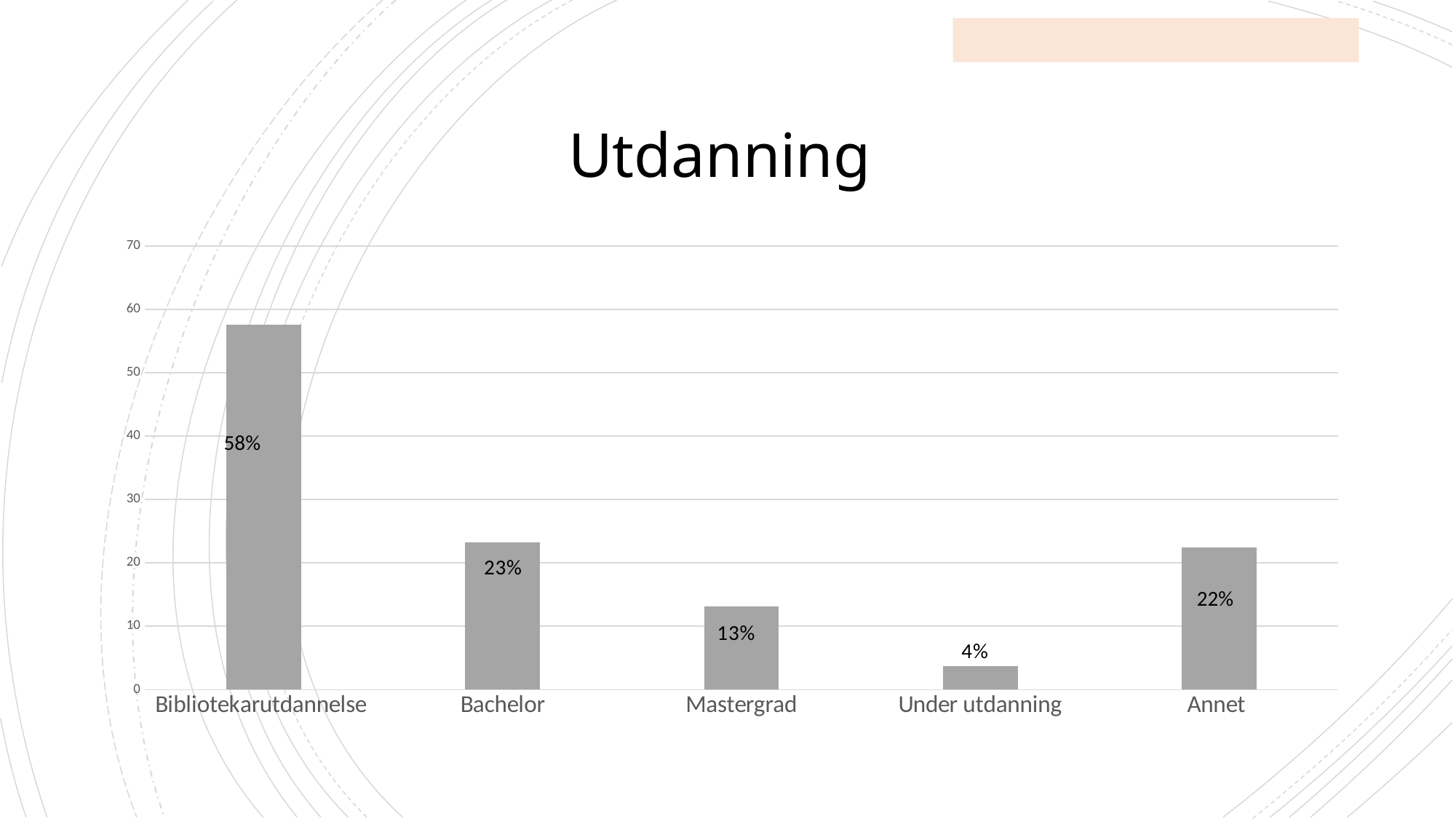
What is the value for Bachelor? 23% What kind of chart is shown on the slide? Bar chart What is the value for Bibliotekarutdannelse? 58% What is the value for Annet? 22% What is the value for Mastergrad? 13% Which is larger, the value for Mastergrad or the value for Annet? Annet Which category has the highest value? Bibliotekarutdannelse Which category has the lowest value? Under utdanning How many categories are shown on the x axis? 5 What is the title of the slide? Utdanning What is the difference between the values for Bibliotekarutdannelse and Bachelor? 35% What is the value for Under utdanning? 4%